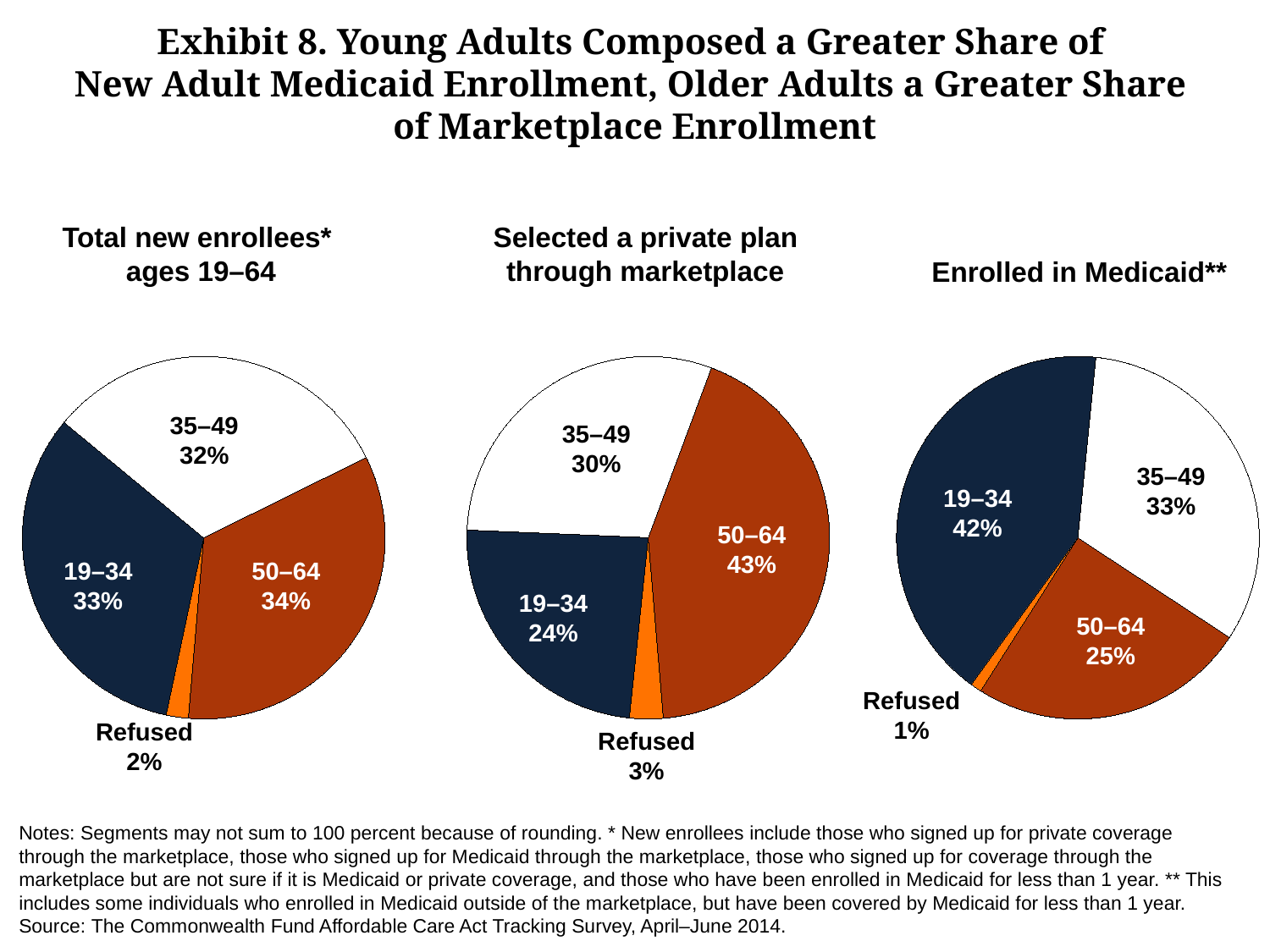
In the 'Selected a private plan through marketplace' pie chart, what is the difference in percentage points between the 50–64 share and the 19–34 share? 19 percentage points In the 'Selected a private plan through marketplace' pie chart, what share is ages 50–64? 43% In the 'Selected a private plan through marketplace' pie chart, which age group has the largest share? 50–64 In the 'Total new enrollees* ages 19–64' pie chart, what share is ages 19–34? 33% What type of chart is used on this slide? Pie chart In the 'Total new enrollees* ages 19–64' pie chart, what share is 'Refused'? 2% In the 'Enrolled in Medicaid**' pie chart, what share is 'Refused'? 1% How many segments does the 'Total new enrollees* ages 19–64' pie chart have? 4 In the 'Enrolled in Medicaid**' pie chart, which is larger: the share for ages 19–34 or the share for ages 50–64? 19–34 How many pie charts are shown on the slide? 3 In the 'Enrolled in Medicaid**' pie chart, which segment is the smallest? Refused In the 'Enrolled in Medicaid**' pie chart, what share is ages 19–34? 42%